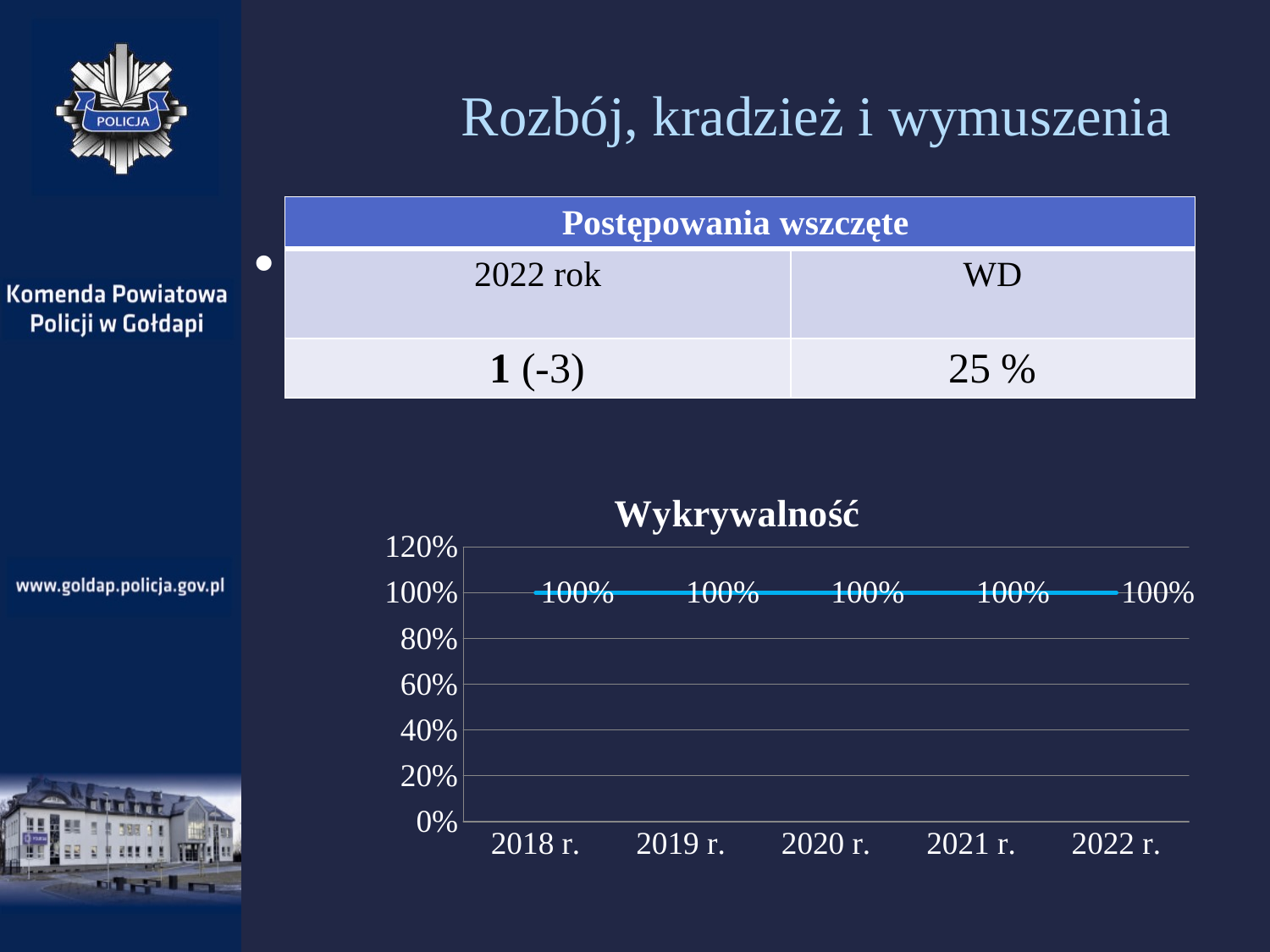
What is the value for 2020 r. in the Wykrywalność chart? 100% Is the value for 2021 r. in the Wykrywalność chart greater or less than 80%? greater What is the difference between the values for 2019 r. and 2021 r. in the Wykrywalność chart? 0% What is the value for 2018 r. in the Wykrywalność chart? 100% What is the value for 2019 r. in the Wykrywalność chart? 100% What is the highest value shown on the y axis of the Wykrywalność chart? 120% What type of chart is shown under the title "Wykrywalność"? line chart What is the title of the chart on the slide? Wykrywalność How many years are plotted on the x axis of the Wykrywalność chart? 5 Do the values in the Wykrywalność chart rise, fall or stay flat from 2018 r. to 2022 r.? stay flat What is the value for 2022 r. in the Wykrywalność chart? 100%